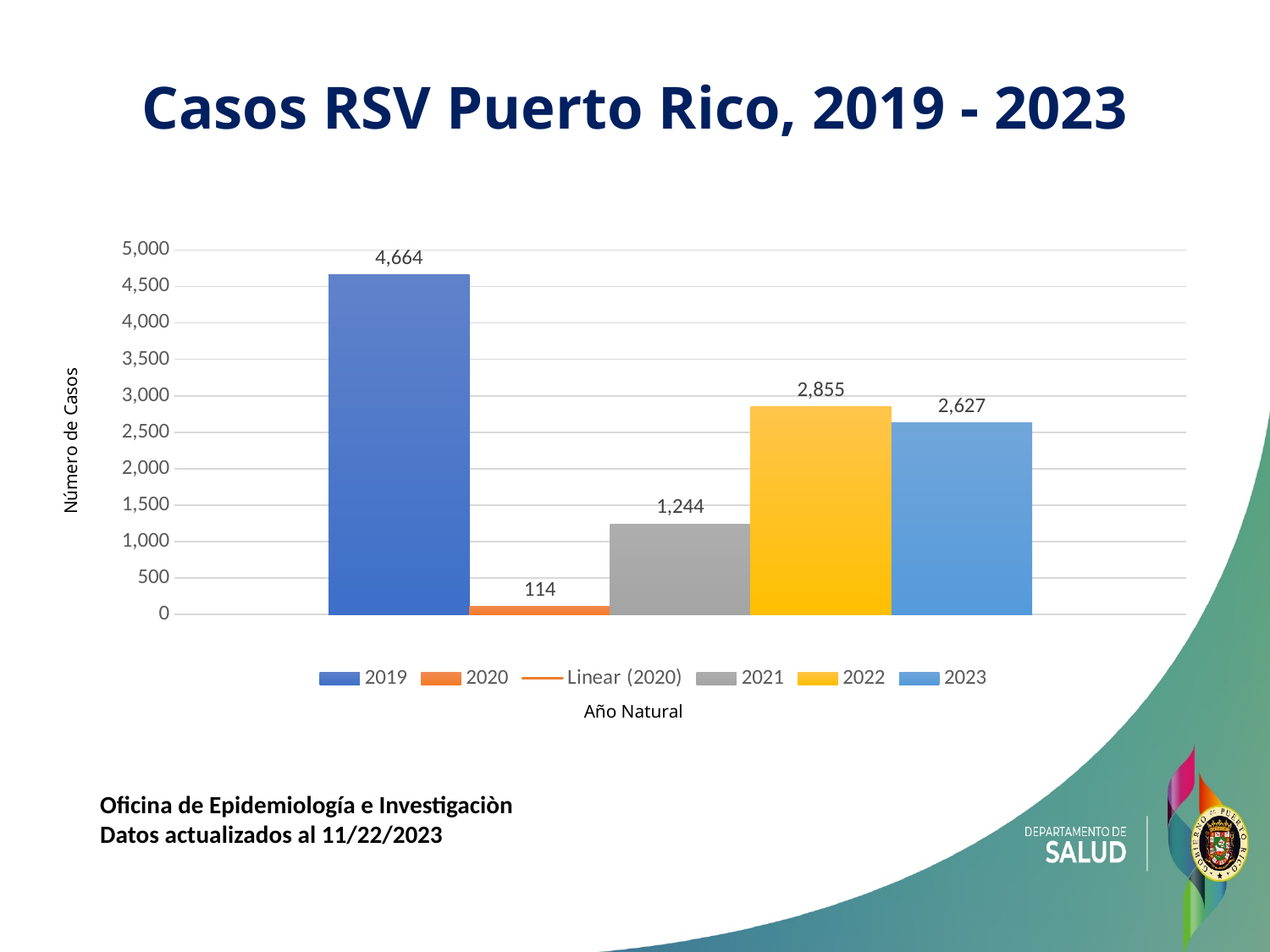
What is the number of cases shown for 2021? 1,244 What type of chart is shown on the slide? bar chart How many RSV cases were reported in Puerto Rico in 2019? 4,664 Which year has the lowest number of RSV cases? 2020 How many years (bars) are plotted in the chart? 5 What is the value shown for 2023? 2,627 What is the value shown for 2020? 114 What is the title of the chart? Casos RSV Puerto Rico, 2019 - 2023 Which year had more cases, 2021 or 2022? 2022 What is the difference in cases between 2022 and 2023? 228 Which year has the highest number of RSV cases? 2019 How many entries does the legend list? 6